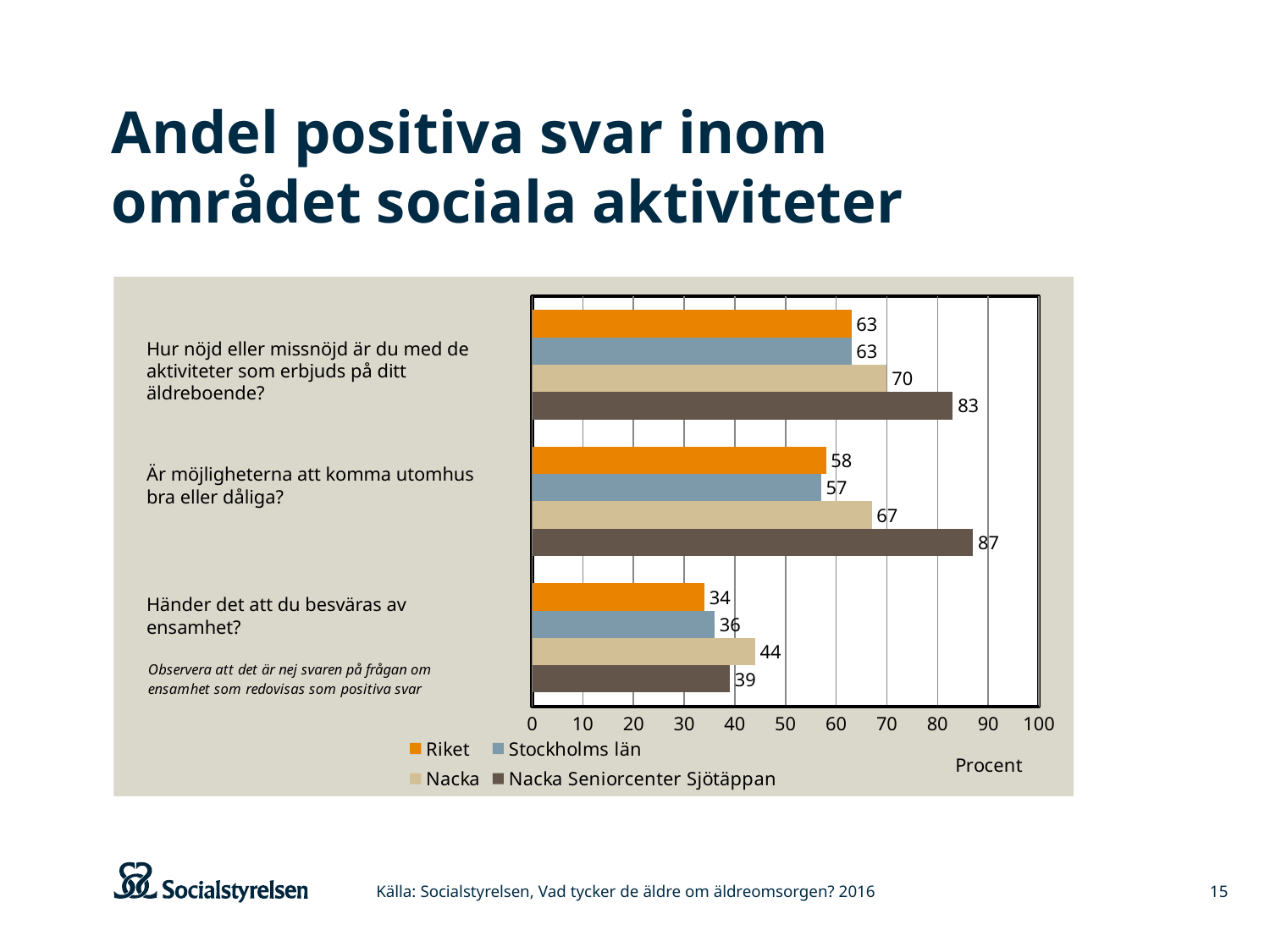
How many questions (categories) are shown on the chart? 3 Which is larger on the question "Händer det att du besväras av ensamhet?": Nacka or Nacka Seniorcenter Sjötäppan? Nacka Which series has the highest value on the question "Hur nöjd eller missnöjd är du med de aktiviteter som erbjuds på ditt äldreboende?"? Nacka Seniorcenter Sjötäppan What is the label of the x axis? Procent What is the value for Nacka on the question "Hur nöjd eller missnöjd är du med de aktiviteter som erbjuds på ditt äldreboende?"? 70 Which series has the lowest value on the question "Händer det att du besväras av ensamhet?"? Riket What is the value for Nacka Seniorcenter Sjötäppan on the question "Är möjligheterna att komma utomhus bra eller dåliga?"? 87 What is the value for Stockholms län on the question "Är möjligheterna att komma utomhus bra eller dåliga?"? 57 What is the difference between Nacka Seniorcenter Sjötäppan and Riket on the question "Är möjligheterna att komma utomhus bra eller dåliga?"? 29 What kind of chart is shown on the slide? Bar chart How many series does the legend list? 4 What is the value for Riket on the question "Händer det att du besväras av ensamhet?"? 34